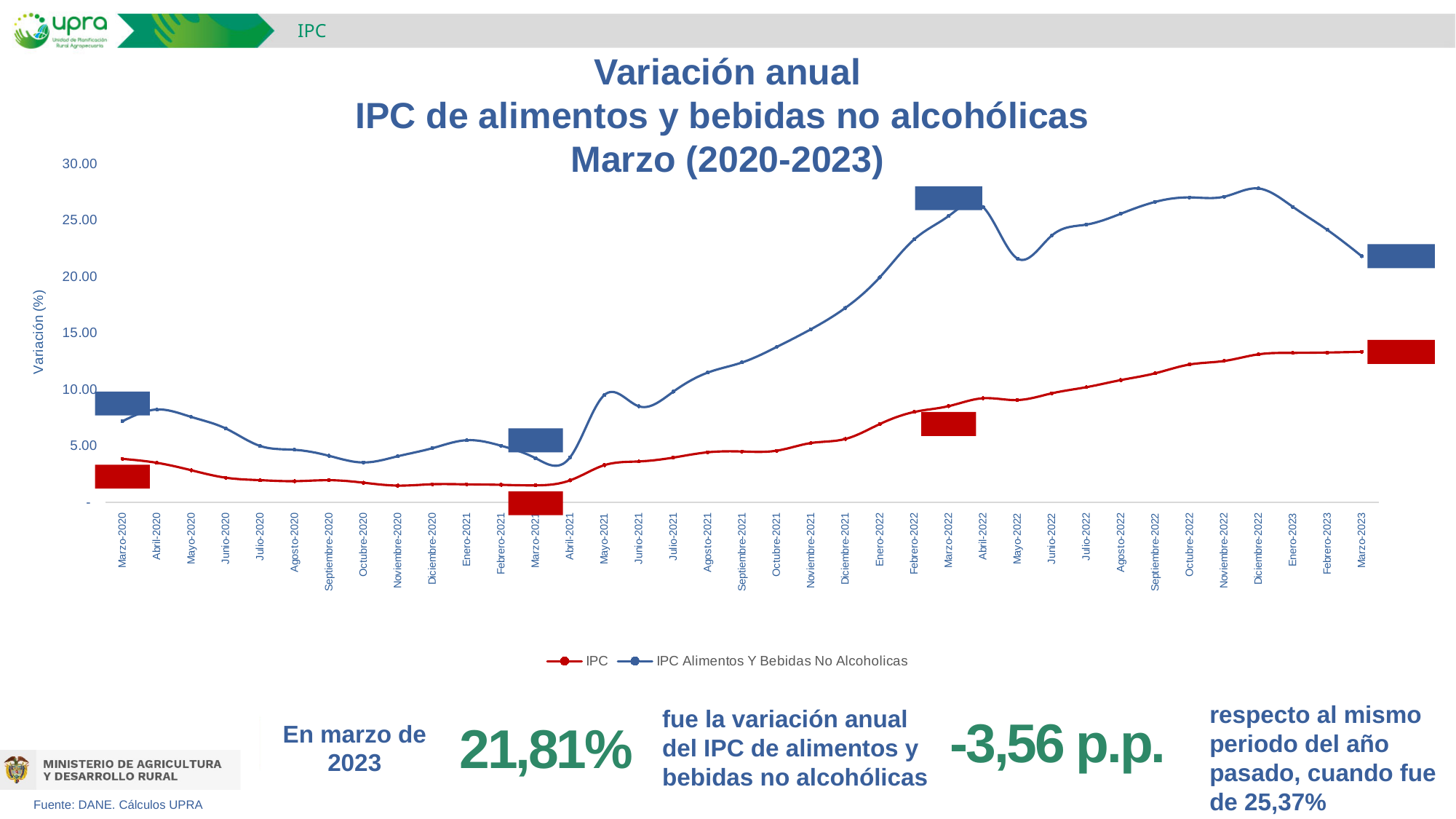
By how many percentage points did the annual variation of the IPC de alimentos y bebidas no alcohólicas change between Marzo-2022 and Marzo-2023? -3,56 p.p. According to the slide, what was the annual variation of the IPC de alimentos y bebidas no alcohólicas in Marzo-2022? 25,37% According to the slide, what was the annual variation of the IPC de alimentos y bebidas no alcohólicas in Marzo-2023? 21,81% Is the value of the IPC Alimentos Y Bebidas No Alcoholicas line for Diciembre-2022 greater or less than 25? greater How many monthly points are plotted along the x axis, from Marzo-2020 to Marzo-2023? 37 In Marzo-2023, which series has the higher value: IPC or IPC Alimentos Y Bebidas No Alcoholicas? IPC Alimentos Y Bebidas No Alcoholicas What is the label on the vertical axis? Variación (%) What are the two series named in the legend? IPC and IPC Alimentos Y Bebidas No Alcoholicas In which month does the IPC Alimentos Y Bebidas No Alcoholicas line reach its highest value? Diciembre-2022 How many series does the legend list? 2 Is the value of the IPC line (red) for Marzo-2023 greater or less than 15? less What kind of chart is shown on the slide? Line chart